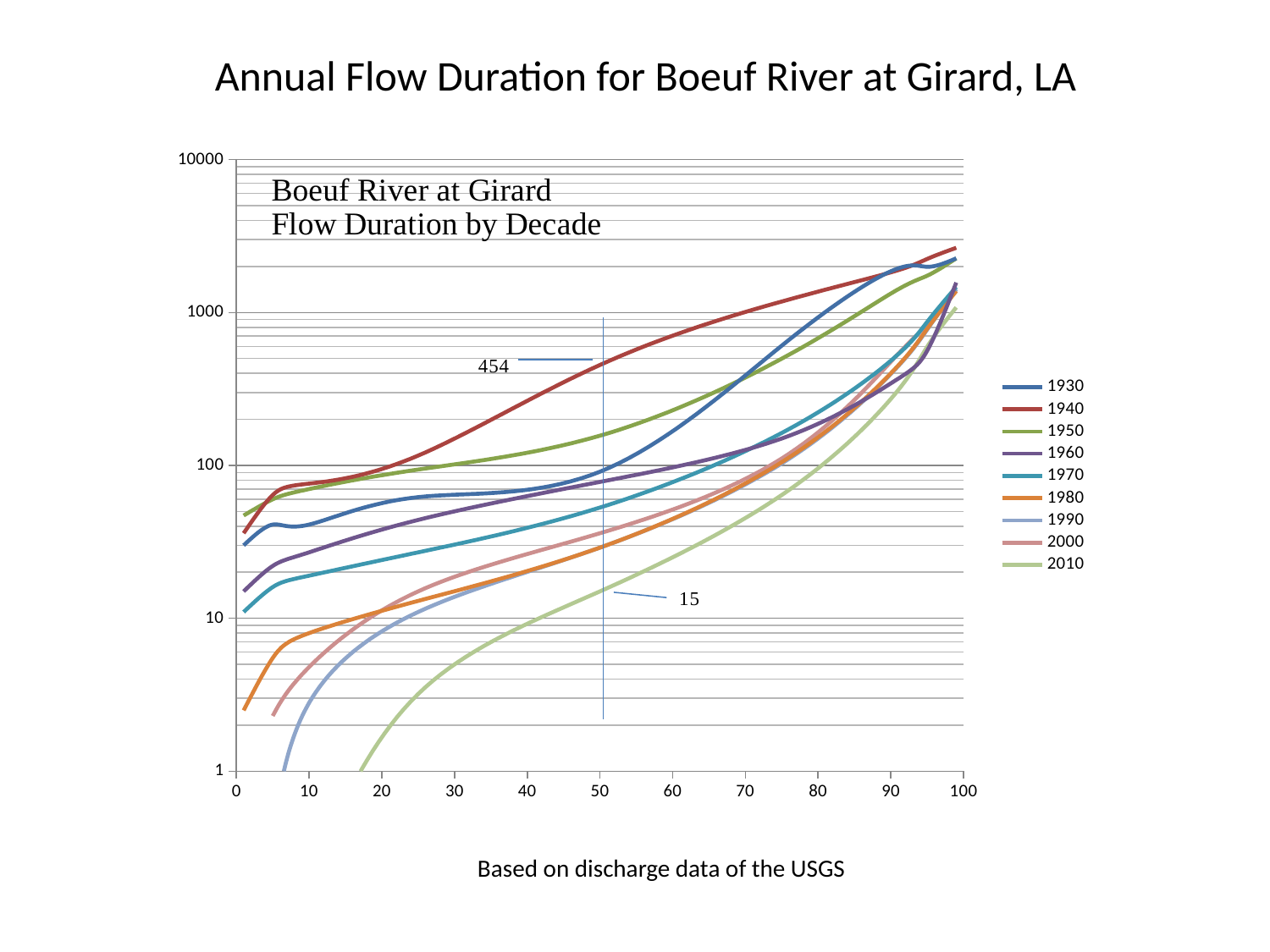
Is the value for the 1970 series at 50 on the x axis greater or less than 100? less What is the title of the slide's chart? Boeuf River at Girard Flow Duration by Decade Which series has the lowest value at 50 on the x axis? 2010 Which series has the highest value at 50 on the x axis? 1940 What kind of chart is shown on the slide? line chart What value is annotated for the 2010 series at 50 on the x axis? 15 According to the note below the chart, what is the data based on? discharge data of the USGS What value is annotated for the 1940 series at 50 on the x axis? 454 At 50 on the x axis, which series has the larger value, 1940 or 2010? 1940 How many series does the legend list? 9 What is the difference between the annotated 1940 value (454) and the annotated 2010 value (15) at 50 on the x axis? 439 Do the values of the series rise or fall as the x axis increases from 0 to 100? rise